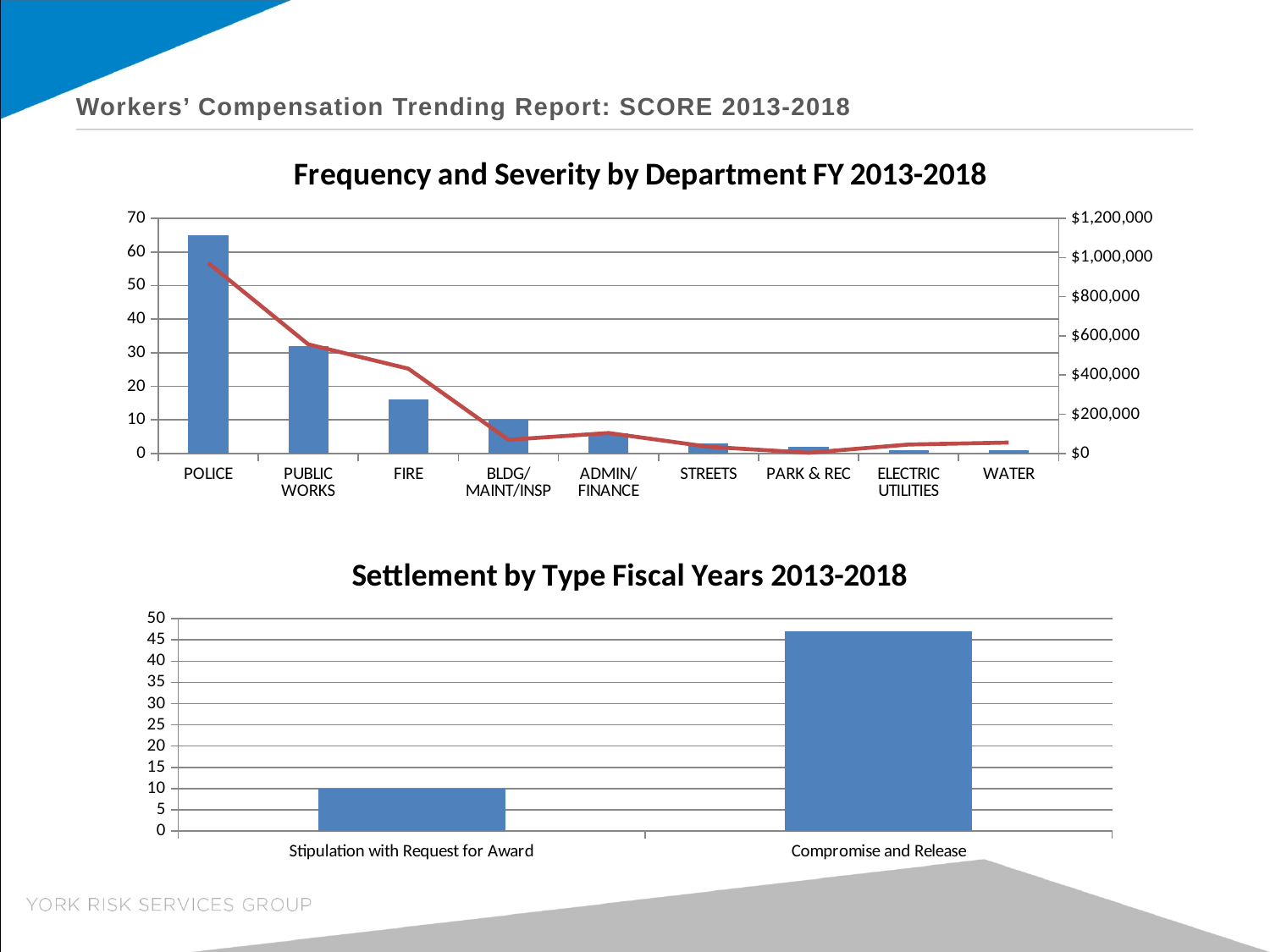
In the 'Frequency and Severity by Department FY 2013-2018' chart, which bar is taller, PUBLIC WORKS or STREETS? PUBLIC WORKS What kind of chart is the 'Settlement by Type Fiscal Years 2013-2018' chart? bar chart In the 'Frequency and Severity by Department FY 2013-2018' chart, how many departments are shown on the x axis? 9 In the 'Frequency and Severity by Department FY 2013-2018' chart, which department has the tallest bar? POLICE In the 'Frequency and Severity by Department FY 2013-2018' chart, is the bar for FIRE greater or less than 20? less In the 'Frequency and Severity by Department FY 2013-2018' chart, do the bar values generally rise or fall from left to right? fall What kind of chart is the 'Frequency and Severity by Department FY 2013-2018' chart? bar chart with a line In the 'Frequency and Severity by Department FY 2013-2018' chart, is the bar for PUBLIC WORKS greater or less than 40? less In the 'Settlement by Type Fiscal Years 2013-2018' chart, how many settlement types are shown? 2 In the 'Settlement by Type Fiscal Years 2013-2018' chart, what is the value for Stipulation with Request for Award? 10 In the 'Settlement by Type Fiscal Years 2013-2018' chart, which settlement type has the higher value? Compromise and Release In the 'Frequency and Severity by Department FY 2013-2018' chart, is the bar for POLICE greater or less than 60? greater